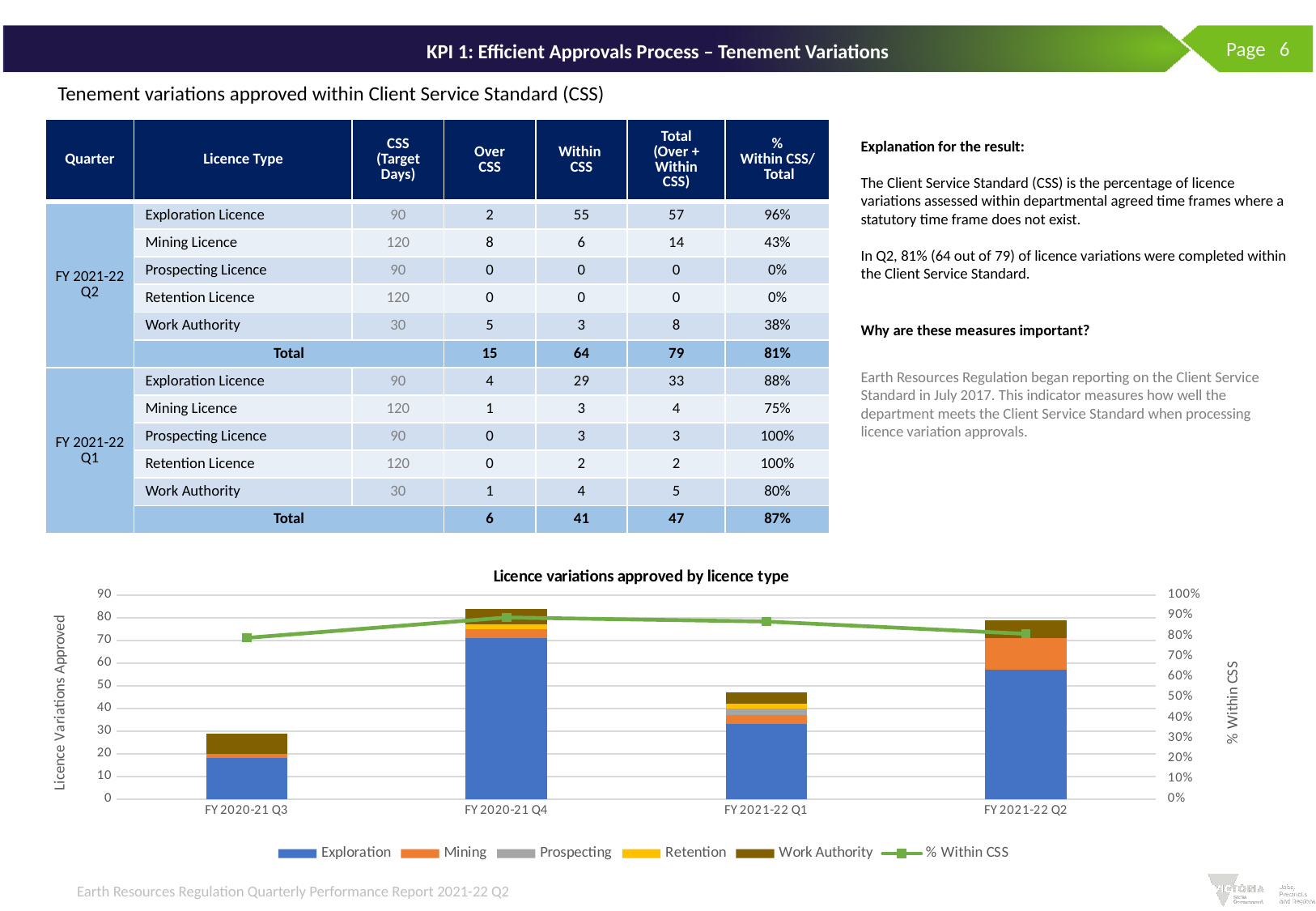
In the 'Licence variations approved by licence type' chart, is the total stacked bar for FY 2020-21 Q4 greater or less than 80? greater In the 'Licence variations approved by licence type' chart, is the Exploration value for FY 2020-21 Q3 greater or less than 10? greater In the 'Licence variations approved by licence type' chart, which quarter has the shortest stacked bar? FY 2020-21 Q3 In the 'Licence variations approved by licence type' chart, which quarter has the tallest stacked bar? FY 2020-21 Q4 What is the label of the right-hand vertical axis of the 'Licence variations approved by licence type' chart? % Within CSS How many series does the legend of the 'Licence variations approved by licence type' chart list? 6 In the 'Licence variations approved by licence type' chart, which stacked bar is taller: FY 2021-22 Q1 or FY 2021-22 Q2? FY 2021-22 Q2 What kind of chart is 'Licence variations approved by licence type'? Stacked bar chart with a line How many quarters are shown on the x axis of the 'Licence variations approved by licence type' chart? 4 In the 'Licence variations approved by licence type' chart, is the % Within CSS value for FY 2020-21 Q3 greater or less than 70%? greater In the 'Licence variations approved by licence type' chart, does the % Within CSS line rise or fall from FY 2020-21 Q4 to FY 2021-22 Q2? falls